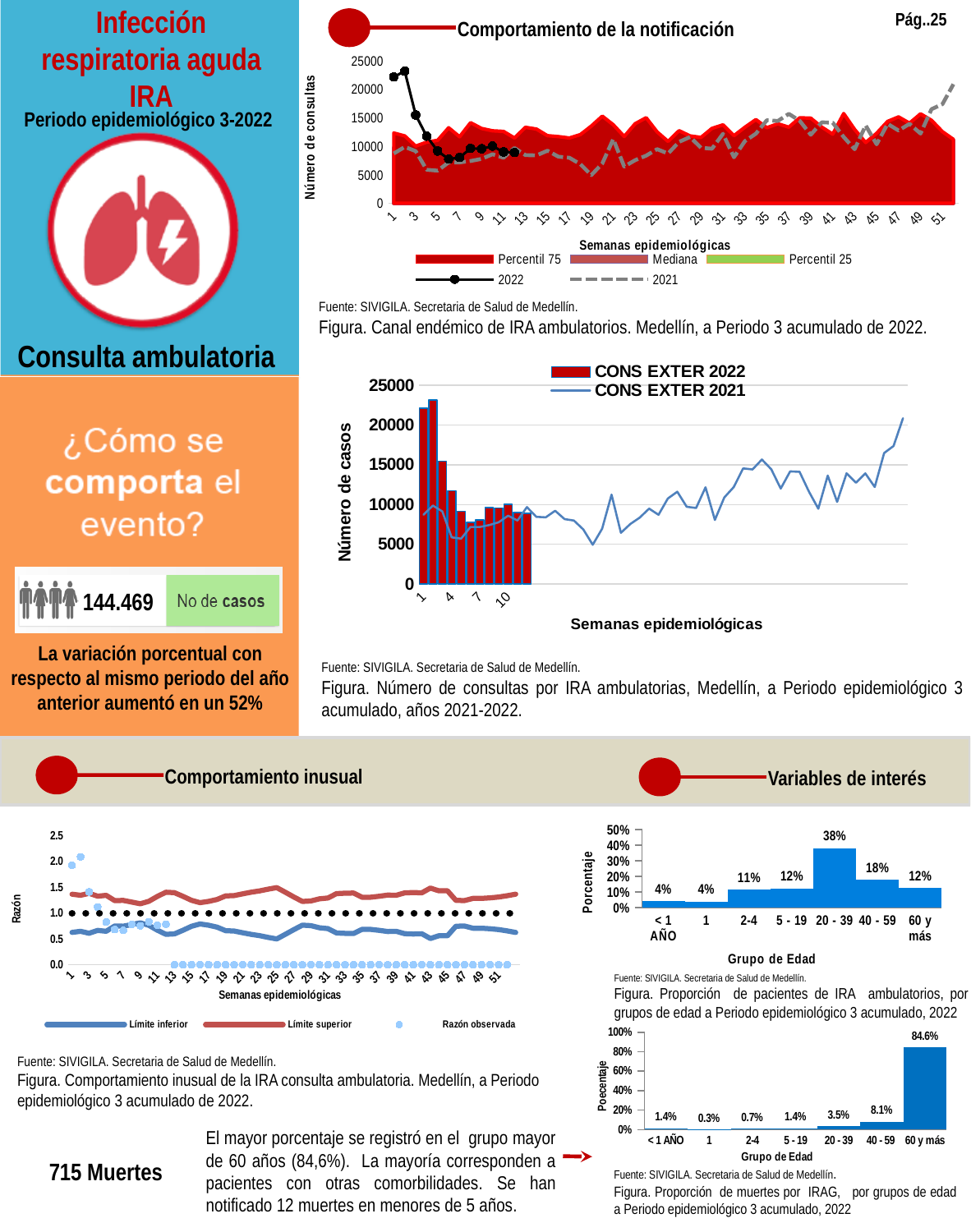
In the chart 'Proporción de muertes por IRAG, por grupos de edad', what is the value for the 2-4 age group? 0.7% In the chart 'Proporción de muertes por IRAG, por grupos de edad', what is the value for the 60 y más group? 84.6% What type of chart is 'Proporción de muertes por IRAG, por grupos de edad'? Bar chart In the chart 'Proporción de muertes por IRAG, por grupos de edad', which is larger: the value for 20 - 39 or for 40 - 59? 40 - 59 In the chart 'Proporción de pacientes de IRA ambulatorios, por grupos de edad', how many age groups are shown? 7 How many series does the legend of the chart 'Número de consultas por IRA ambulatorias' list? 2 How many series does the legend of the chart 'Canal endémico de IRA ambulatorios' list? 5 In the chart 'Proporción de pacientes de IRA ambulatorios, por grupos de edad', what is the value for the 20 - 39 age group? 38% In the chart 'Comportamiento inusual de la IRA consulta ambulatoria', what are the three legend entries? Límite inferior, Límite superior, Razón observada In the chart 'Proporción de pacientes de IRA ambulatorios, por grupos de edad', which age group has the highest proportion? 20 - 39 In the chart 'Proporción de pacientes de IRA ambulatorios, por grupos de edad', what is the difference between the 40 - 59 and 60 y más groups? 6% In the chart 'Proporción de muertes por IRAG, por grupos de edad', which age group has the lowest proportion? 1